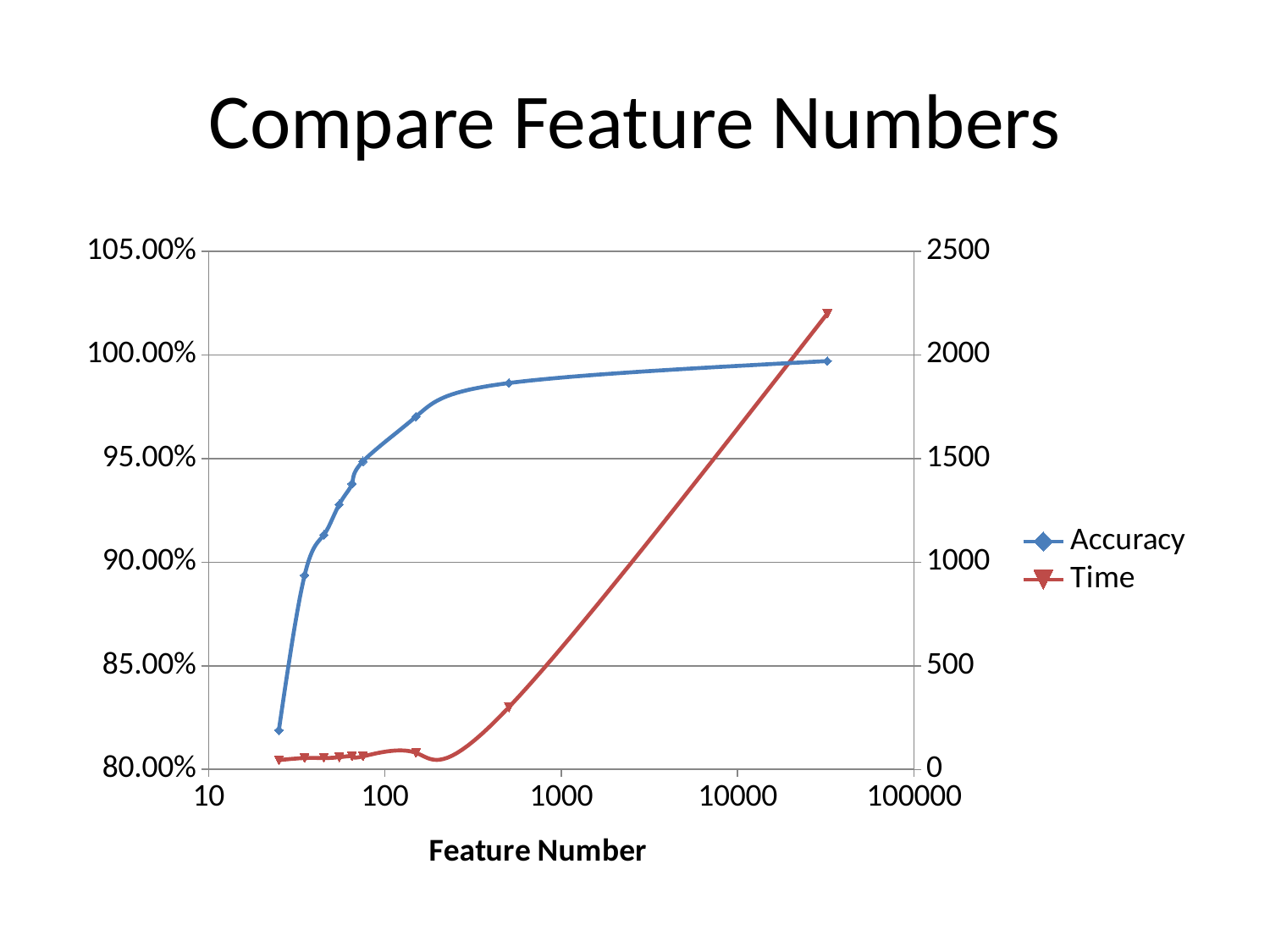
Is the Time value at the largest feature number greater or less than 2000? greater What are the two series named in the legend? Accuracy and Time Which is larger, the Time value at the largest feature number or the Time value at the smallest feature number? the largest feature number What kind of chart is shown on the slide? line chart What is the label of the x axis? Feature Number How many series does the legend list? 2 At which end of the x axis does the Accuracy series reach its lowest value? the smallest feature number (left end) Does the Accuracy series rise or fall as the feature number increases? rise Does the Time series rise or fall as the feature number increases? rise Is the Accuracy value at the smallest feature number greater or less than 85.00%? less Is the Accuracy value at the largest feature number greater or less than 100.00%? less